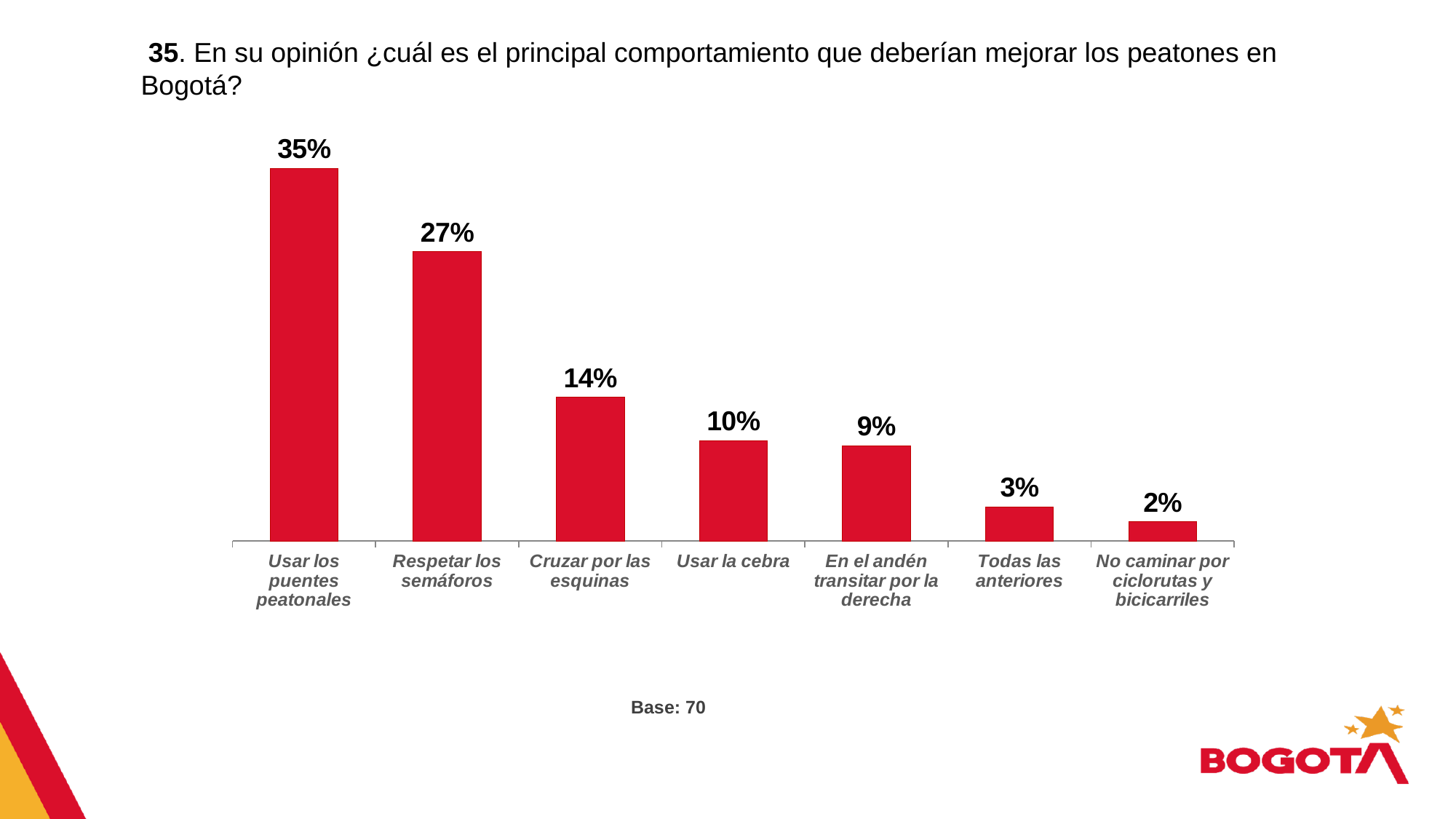
What is the value for "No caminar por ciclorutas y bicicarriles"? 2% What percentage is shown for "Usar la cebra"? 10% What is the value for "Respetar los semáforos"? 27% Which category has the highest value? Usar los puentes peatonales What kind of chart is shown on the slide? Bar chart What percentage is shown for "Usar los puentes peatonales"? 35% What is the difference between "Usar los puentes peatonales" and "Respetar los semáforos"? 8% What is the base (number of respondents) stated below the chart? 70 How many categories are shown in the chart? 7 What is the difference between "Cruzar por las esquinas" and "Todas las anteriores"? 11% Which is larger, "Usar la cebra" or "En el andén transitar por la derecha"? Usar la cebra Which category has the lowest value? No caminar por ciclorutas y bicicarriles